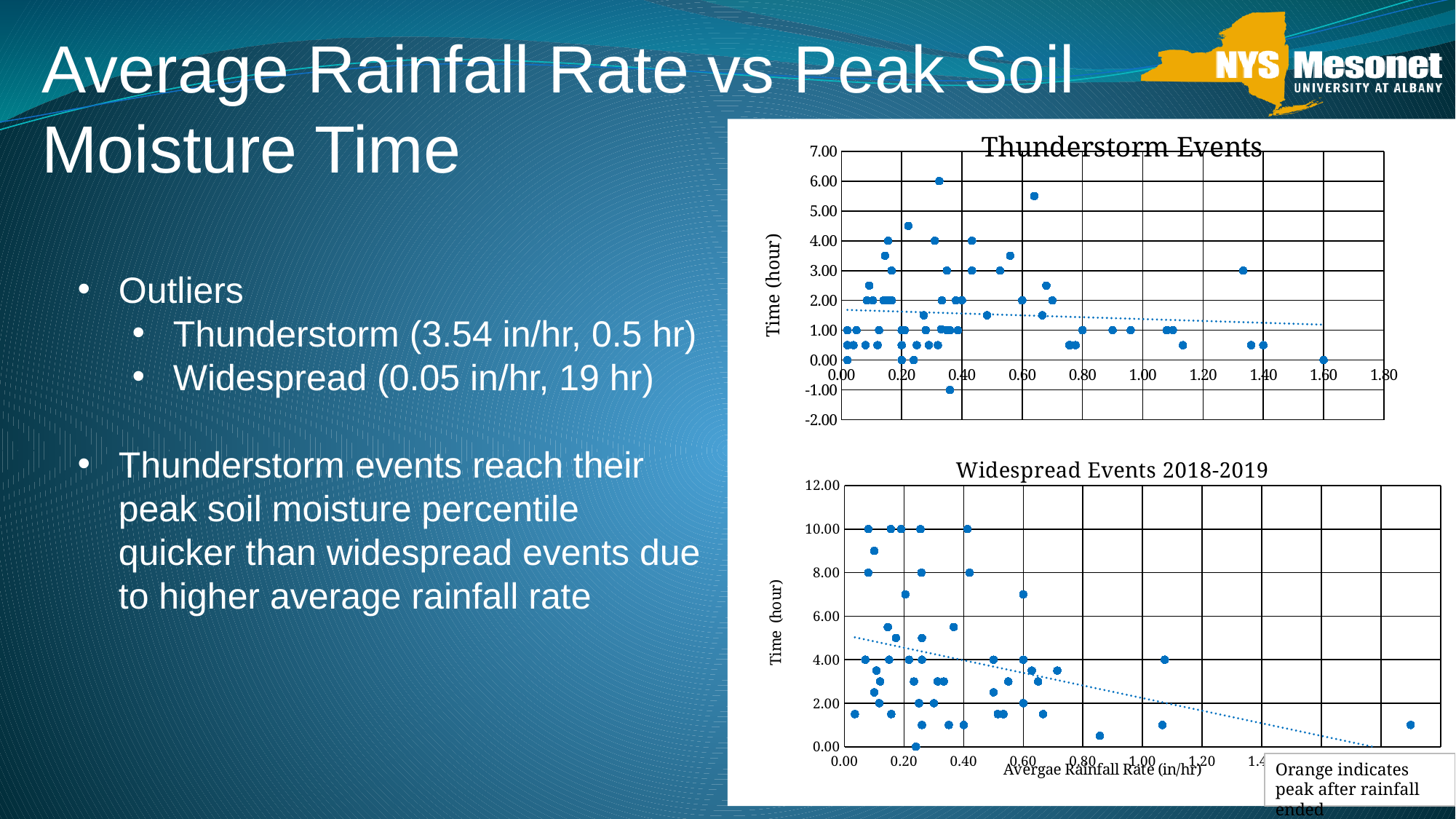
What is the title of the lower chart on the slide? Widespread Events 2018-2019 In the Thunderstorm Events chart, is the time of the lowest plotted point greater or less than 0.00? less In the Widespread Events 2018-2019 chart, is the time of the highest plotted points greater or less than 9.00? greater In the Thunderstorm Events chart, does the dotted trend line rise or fall as average rainfall rate increases? Fall How many charts are shown on the slide? 2 In the Widespread Events 2018-2019 chart, does the dotted trend line rise or fall as average rainfall rate increases? Fall What kind of chart is the Widespread Events 2018-2019 chart? Scatter chart In the Widespread Events 2018-2019 chart, is the time of the rightmost plotted point (near 1.80 in/hr) greater or less than 2.00? less What kind of chart is the Thunderstorm Events chart? Scatter chart What is the y-axis label on the Thunderstorm Events chart? Time (hour)